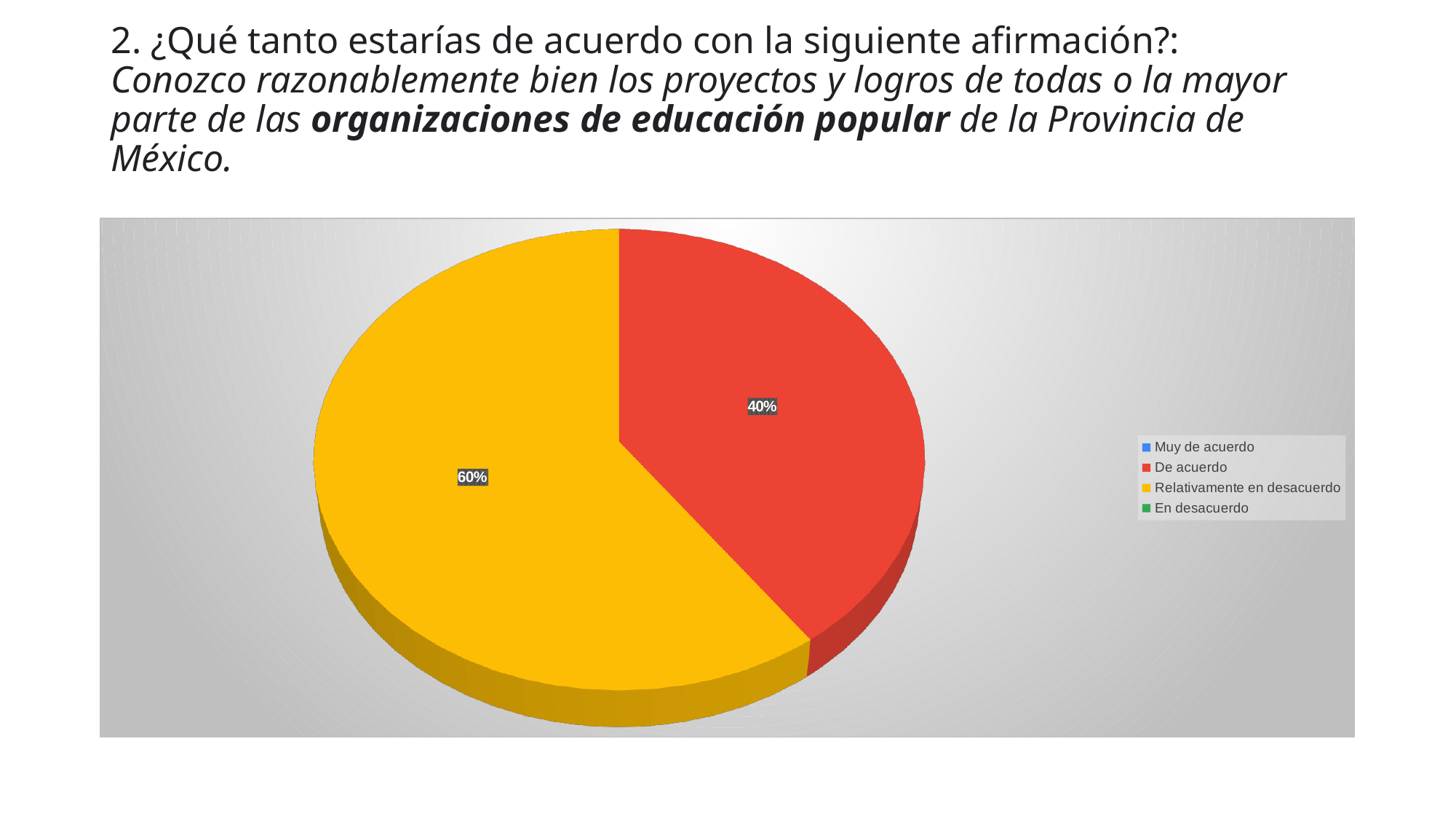
How many slices are visible in the pie? 2 What colour does the legend assign to 'De acuerdo'? red What percentage of the pie is labelled for 'Relativamente en desacuerdo'? 60% What is the difference in percentage points between the 'Relativamente en desacuerdo' share and the 'De acuerdo' share? 20% What percentage of the pie is labelled for 'De acuerdo'? 40% Is the share for 'De acuerdo' greater or less than 50%? less How many entries does the legend list? 4 Which is larger, the share for 'De acuerdo' or the share for 'Relativamente en desacuerdo'? Relativamente en desacuerdo Which category has the largest share of the pie? Relativamente en desacuerdo What kind of chart is shown on the slide? pie chart What colour is the slice for 'Relativamente en desacuerdo'? yellow